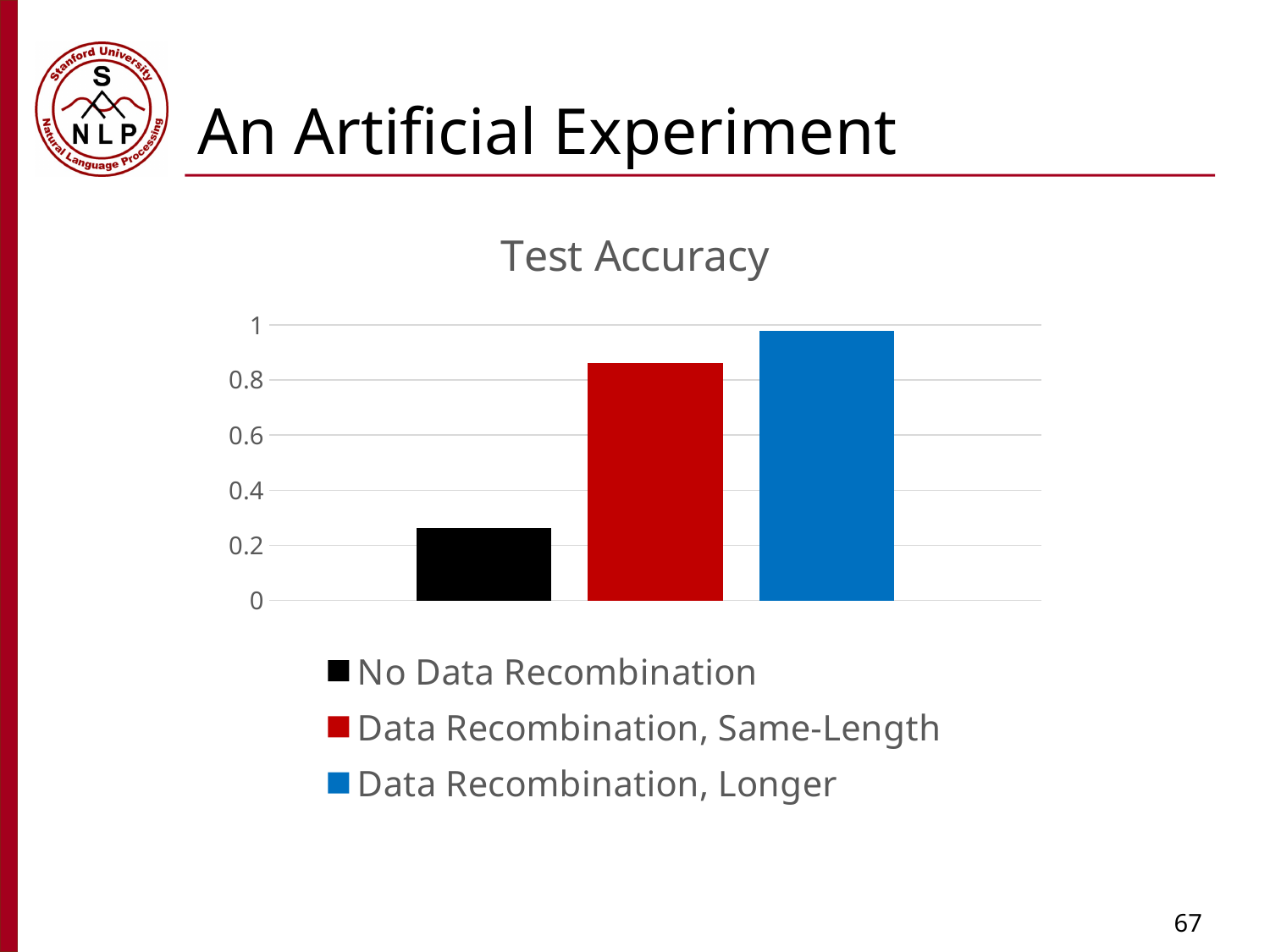
Is the test accuracy for Data Recombination, Same-Length greater or less than 0.8? greater Which is larger, the test accuracy for Data Recombination, Same-Length or for Data Recombination, Longer? Data Recombination, Longer What colour is the bar for Data Recombination, Longer? blue Is the test accuracy for No Data Recombination greater or less than 0.4? less Which series has the highest test accuracy? Data Recombination, Longer How many series does the legend list? 3 Which series has the lowest test accuracy? No Data Recombination What is the title of the chart? Test Accuracy Is the test accuracy for Data Recombination, Longer greater or less than 0.8? greater Which is larger, the test accuracy for No Data Recombination or for Data Recombination, Same-Length? Data Recombination, Same-Length Do the bars rise or fall from left to right across the chart? rise What kind of chart is shown on the slide? bar chart